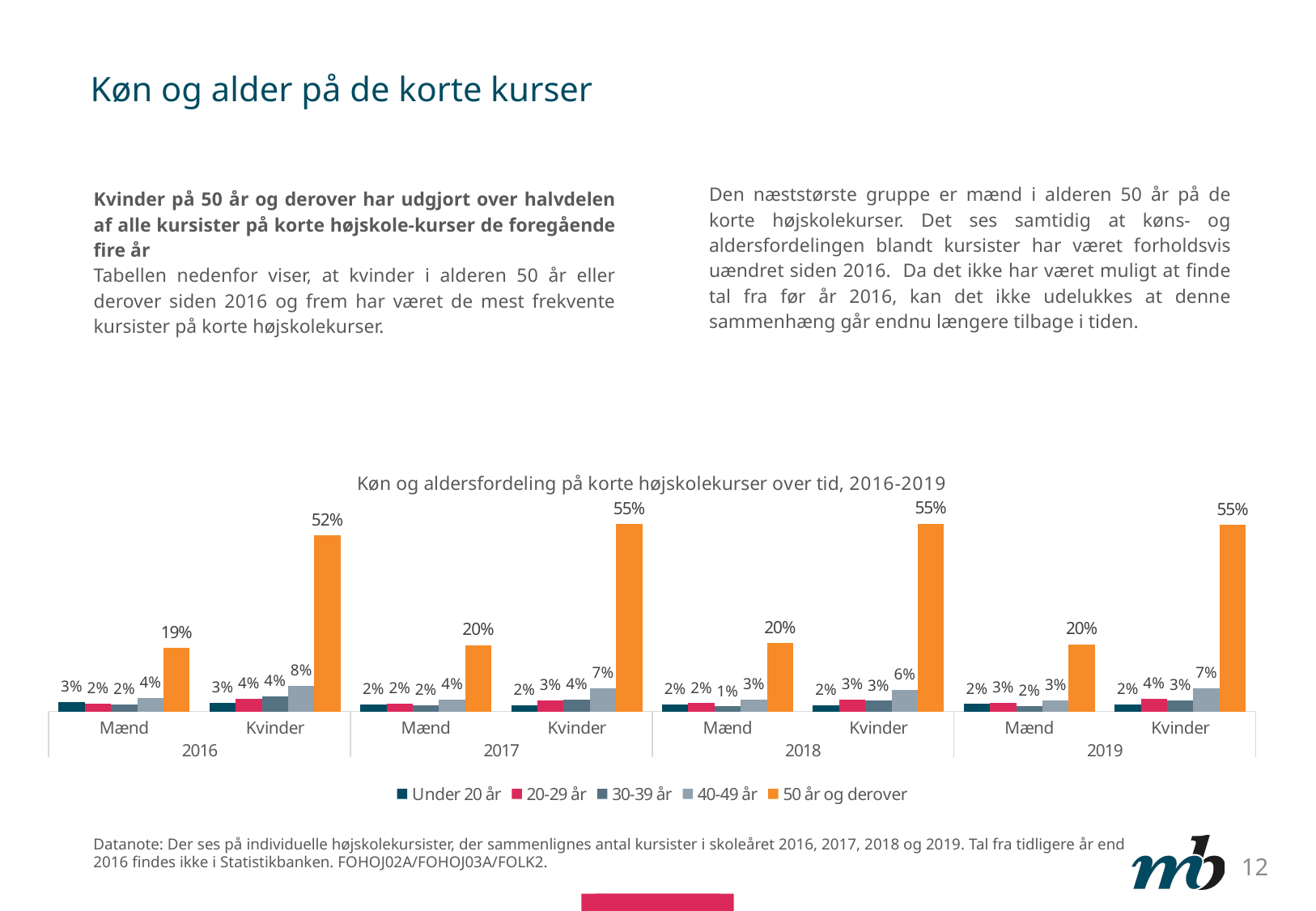
What kind of chart is shown on the slide? Bar chart What is the value for '30-39 år' among Mænd in 2018? 1% How many Mænd/Kvinder groups are plotted along the x axis? 8 What is the value for '50 år og derover' among Mænd in 2016? 19% What is the difference between the '50 år og derover' value for Kvinder in 2017 and in 2016? 3% How many series does the legend list? 5 What is the difference between the '50 år og derover' values for Kvinder and Mænd in 2017? 35% What is the title of the chart? Køn og aldersfordeling på korte højskolekurser over tid, 2016-2019 What is the value for '40-49 år' among Kvinder in 2016? 8% What is the value for '50 år og derover' among Kvinder in 2016? 52% Which group has the highest value for '50 år og derover' in 2016, Mænd or Kvinder? Kvinder What is the value for '40-49 år' among Kvinder in 2019? 7%